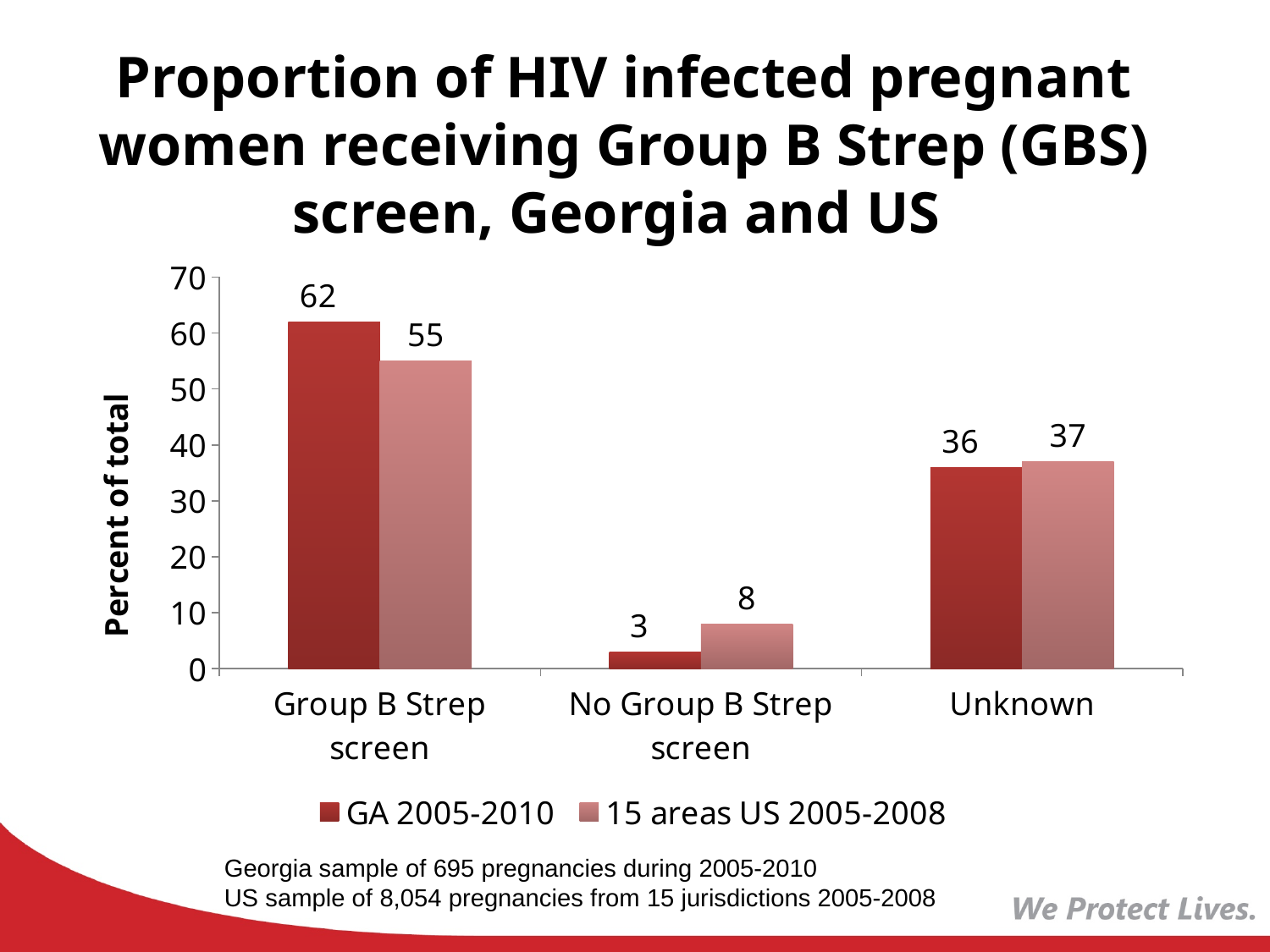
What is the difference between the GA 2005-2010 and 15 areas US 2005-2008 values in the Group B Strep screen category? 7 How many categories are shown on the x axis? 3 What is the value for 15 areas US 2005-2008 in the No Group B Strep screen category? 8 Which category has the lowest value for the 15 areas US 2005-2008 series? No Group B Strep screen Which category has the highest value for the GA 2005-2010 series? Group B Strep screen What is the value for 15 areas US 2005-2008 in the Unknown category? 37 Is the value for GA 2005-2010 in the Unknown category greater or less than 40? less What kind of chart is shown on the slide? bar chart In the No Group B Strep screen category, which series has the larger value, GA 2005-2010 or 15 areas US 2005-2008? 15 areas US 2005-2008 What is the value for GA 2005-2010 in the Group B Strep screen category? 62 What is the label of the vertical axis? Percent of total How many series does the legend list? 2